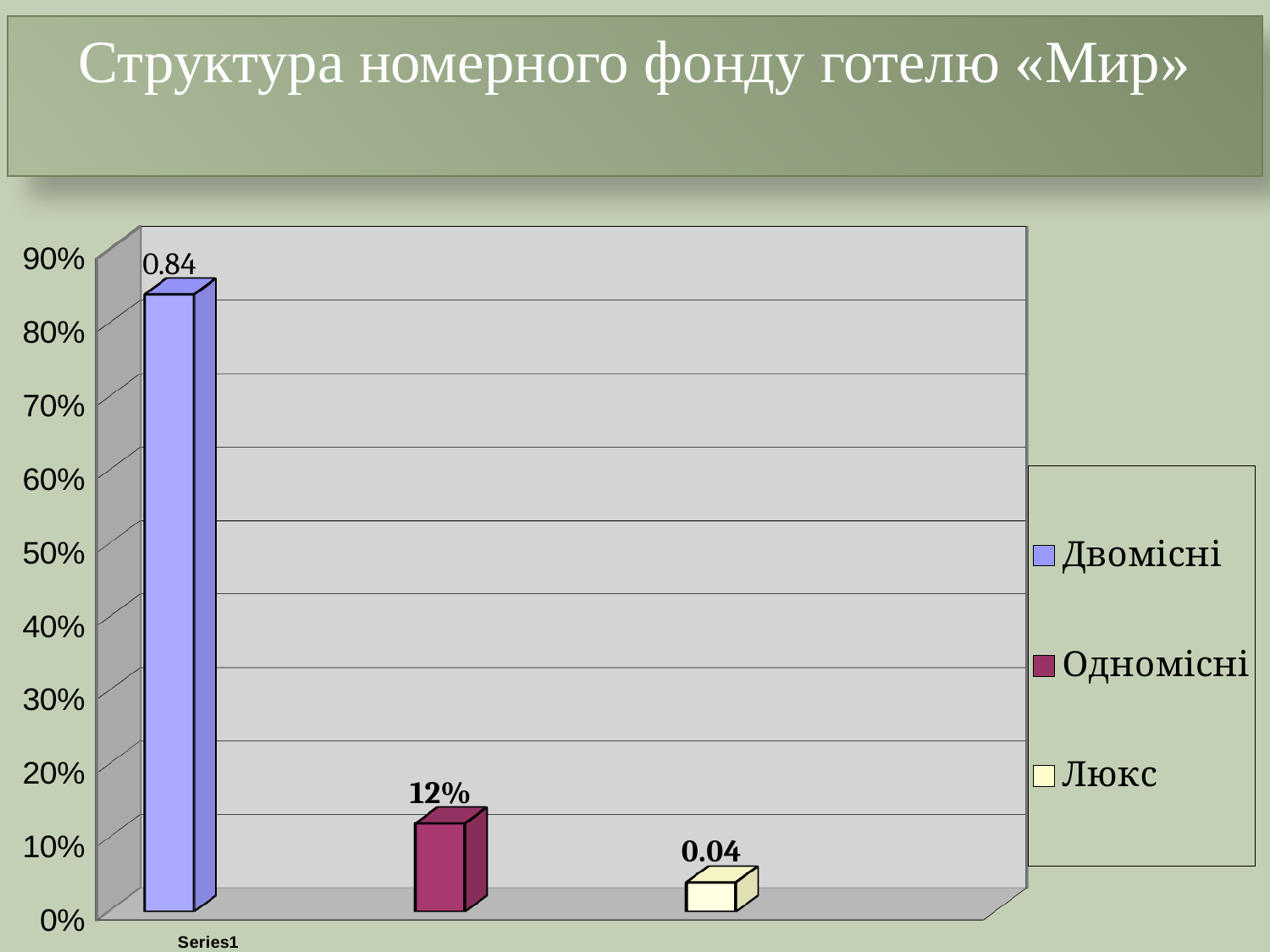
What kind of chart is shown on the slide? Bar chart What value is shown for Одномісні? 12% Is the value for Двомісні greater or less than 80%? greater Is the value for Люкс greater or less than 10%? less How many bars are plotted on the chart? 3 Which is larger, the value for Одномісні or the value for Люкс? Одномісні What is the title of the slide? Структура номерного фонду готелю «Мир» What value is shown for Двомісні? 0.84 Which category has the highest value? Двомісні Which category has the lowest value? Люкс What value is shown for Люкс? 0.04 How many series does the legend list? 3